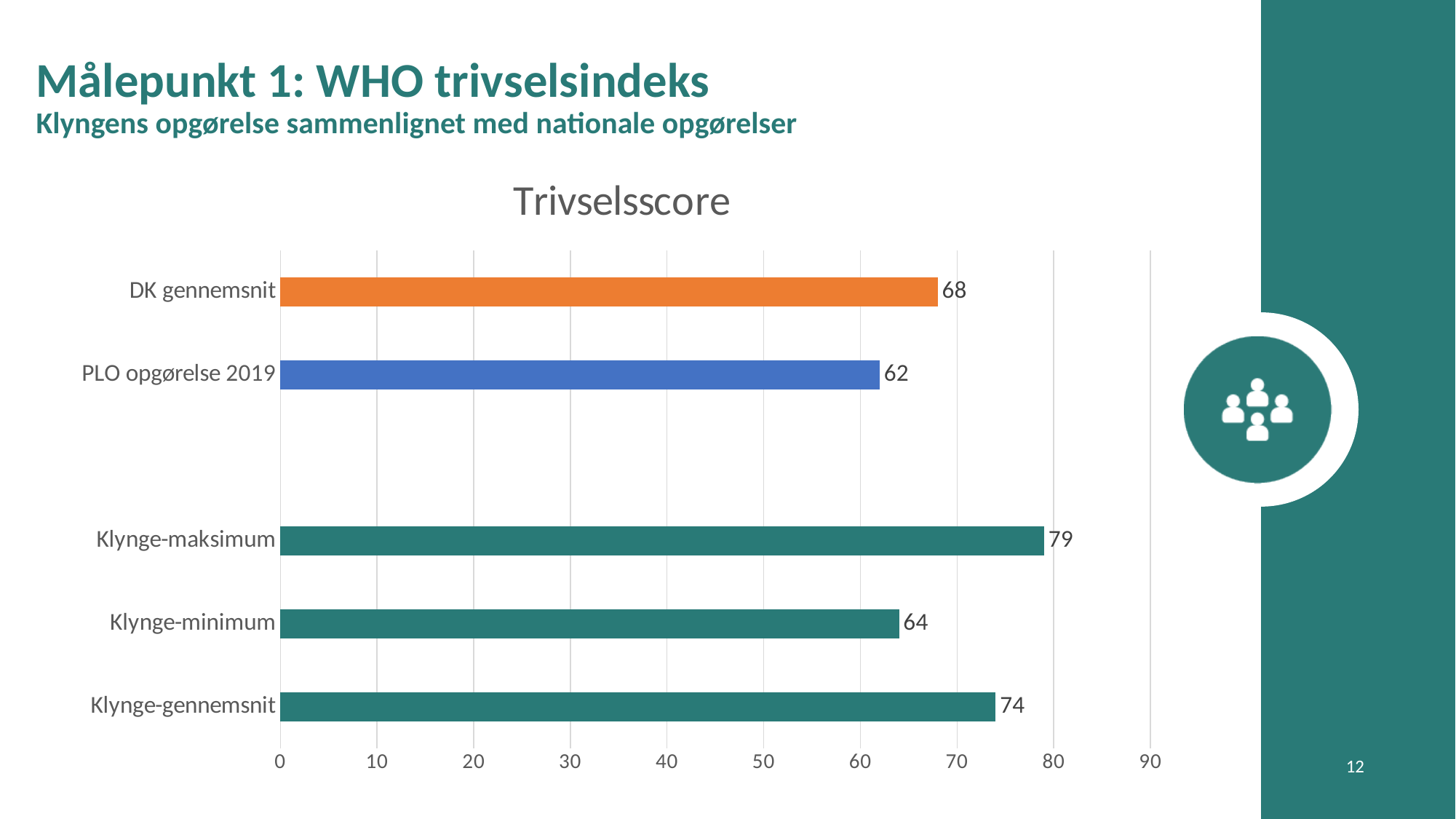
How many bars are shown in the chart? 5 What is the title of the chart? Trivselsscore What is the difference between Klynge-gennemsnit and DK gennemsnit? 6 What is the value for Klynge-minimum? 64 What is the difference between Klynge-maksimum and Klynge-minimum? 15 What is the value for Klynge-gennemsnit? 74 What is the value for DK gennemsnit? 68 Which category has the lowest value? PLO opgørelse 2019 What kind of chart is shown? bar chart Which category has the highest value? Klynge-maksimum What is the value for PLO opgørelse 2019? 62 Which is larger, DK gennemsnit or PLO opgørelse 2019? DK gennemsnit